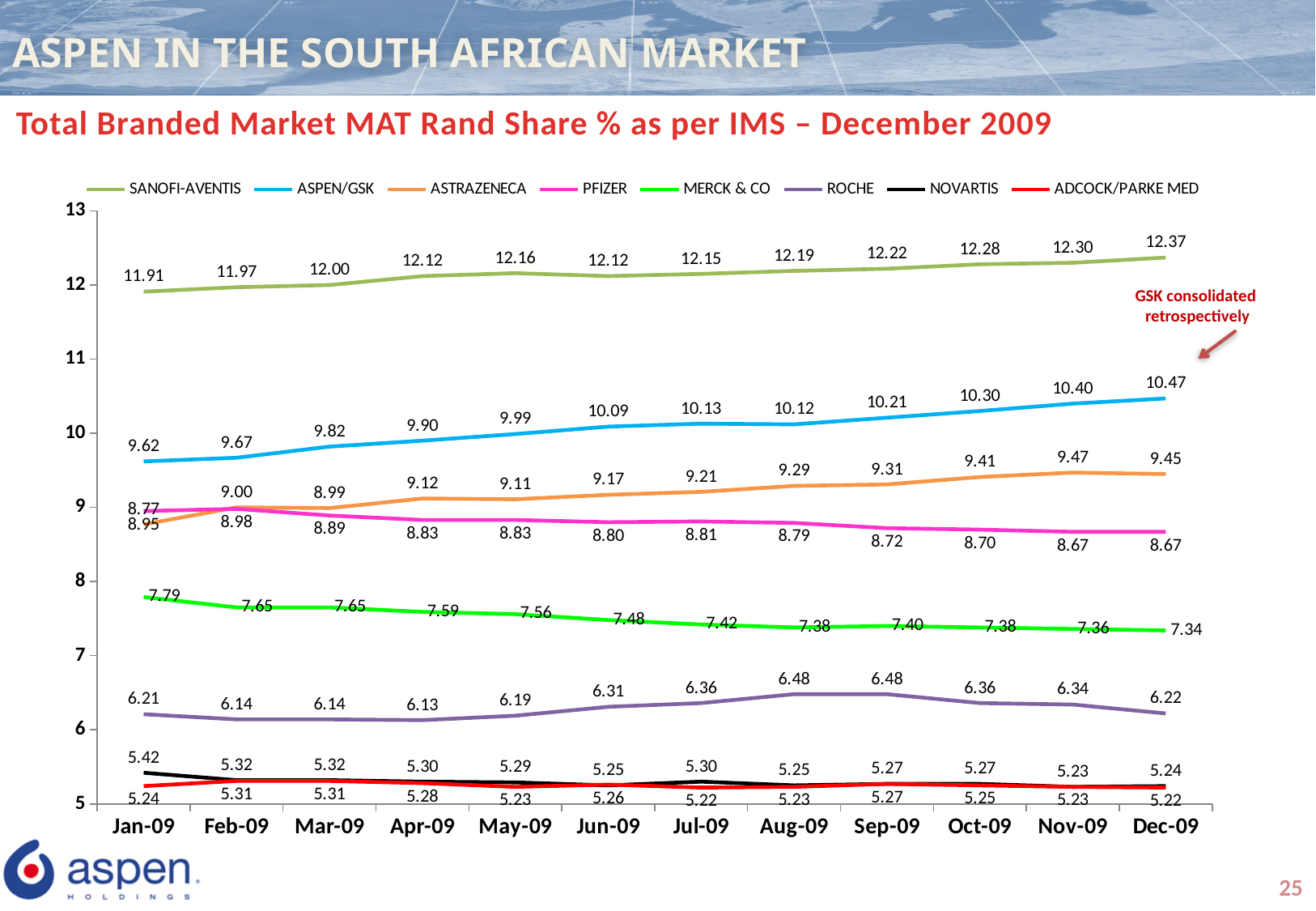
What is the value for SANOFI-AVENTIS in Jan-09? 11.91 How many series does the legend list? 8 Which is larger in Nov-09, the ASTRAZENECA value or the PFIZER value? ASTRAZENECA In which month is the ASPEN/GSK value lowest? Jan-09 What is the difference between the ASPEN/GSK values in Dec-09 and Jan-09? 0.85 What is the value for ASPEN/GSK in Dec-09? 10.47 Which company has the highest share in Dec-09? SANOFI-AVENTIS Does the MERCK & CO line rise or fall from Jan-09 to Dec-09? fall How many months are plotted along the x axis? 12 What type of chart is shown on the slide? line chart What is the value for ROCHE in Aug-09? 6.48 What is the value for MERCK & CO in Jun-09? 7.48